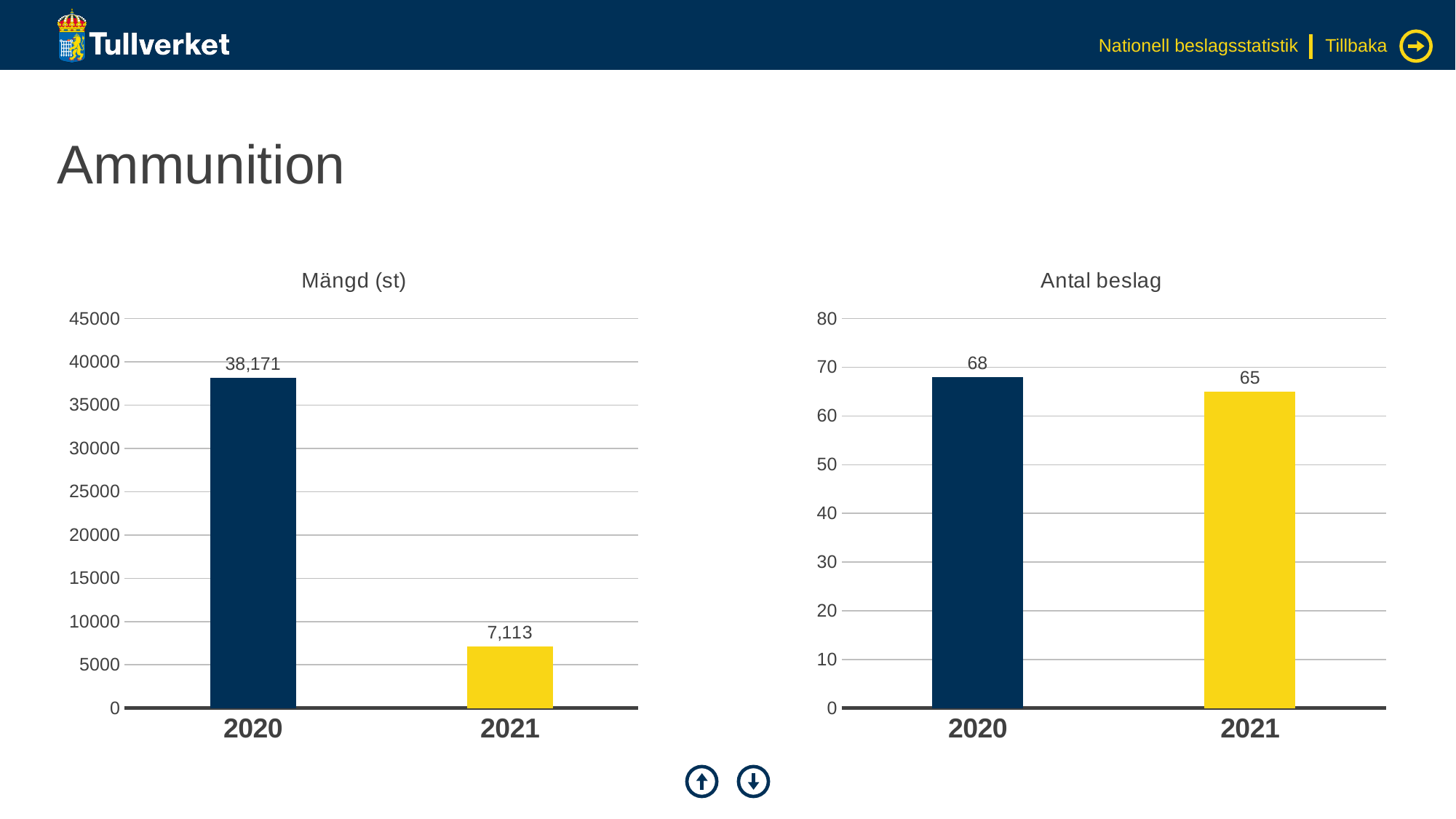
In the 'Antal beslag' chart, what is the difference between the 2020 and 2021 values? 3 In the 'Mängd (st)' chart, is the value for 2021 greater or less than 10000? less In the 'Antal beslag' chart, which year has the lowest value? 2021 In the 'Mängd (st)' chart, what is the difference between the 2020 and 2021 values? 31,058 In the 'Mängd (st)' chart, what is the value for 2020? 38,171 In the 'Mängd (st)' chart, what is the value for 2021? 7,113 In the 'Antal beslag' chart, do the values rise or fall from 2020 to 2021? fall In the 'Antal beslag' chart, how many years are shown on the x axis? 2 In the 'Antal beslag' chart, what is the value for 2021? 65 What kind of chart is the 'Mängd (st)' chart? bar chart In the 'Mängd (st)' chart, which year has the highest value? 2020 In the 'Antal beslag' chart, what is the value for 2020? 68